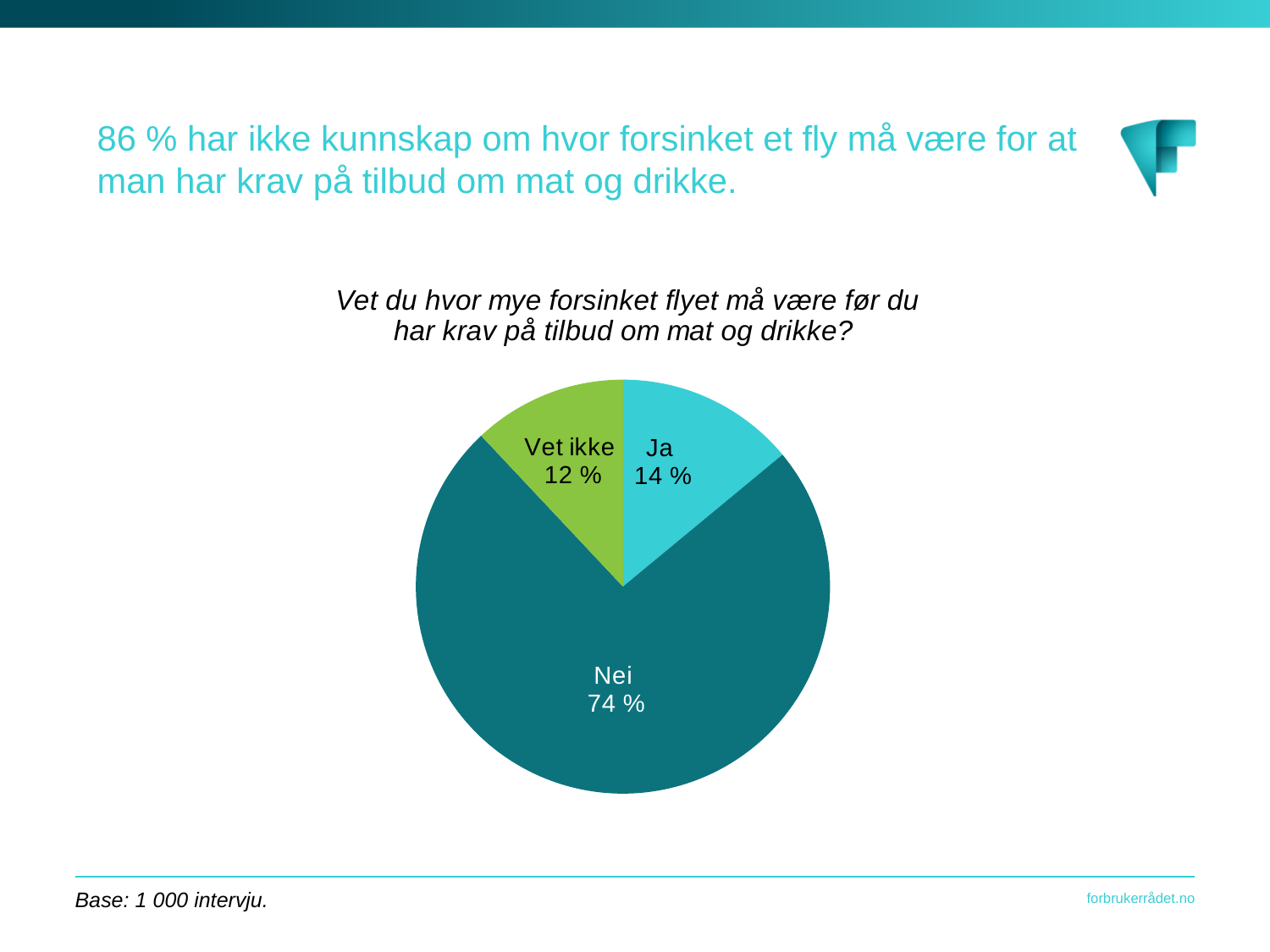
What percentage of respondents answered "Vet ikke"? 12 % What question is shown as the title of the pie chart? Vet du hvor mye forsinket flyet må være før du har krav på tilbud om mat og drikke? What percentage of respondents answered "Ja"? 14 % What percentage of respondents answered "Nei"? 74 % What is the difference in percentage points between "Nei" and "Ja"? 60 What type of chart is shown on the slide? Pie chart Which is larger, the share for "Ja" or the share for "Vet ikke"? Ja How many slices does the pie chart have? 3 What is the combined share of "Ja" and "Vet ikke"? 26 % Which response has the largest share of the pie? Nei What is the difference in percentage points between "Ja" and "Vet ikke"? 2 Which response has the smallest share of the pie? Vet ikke